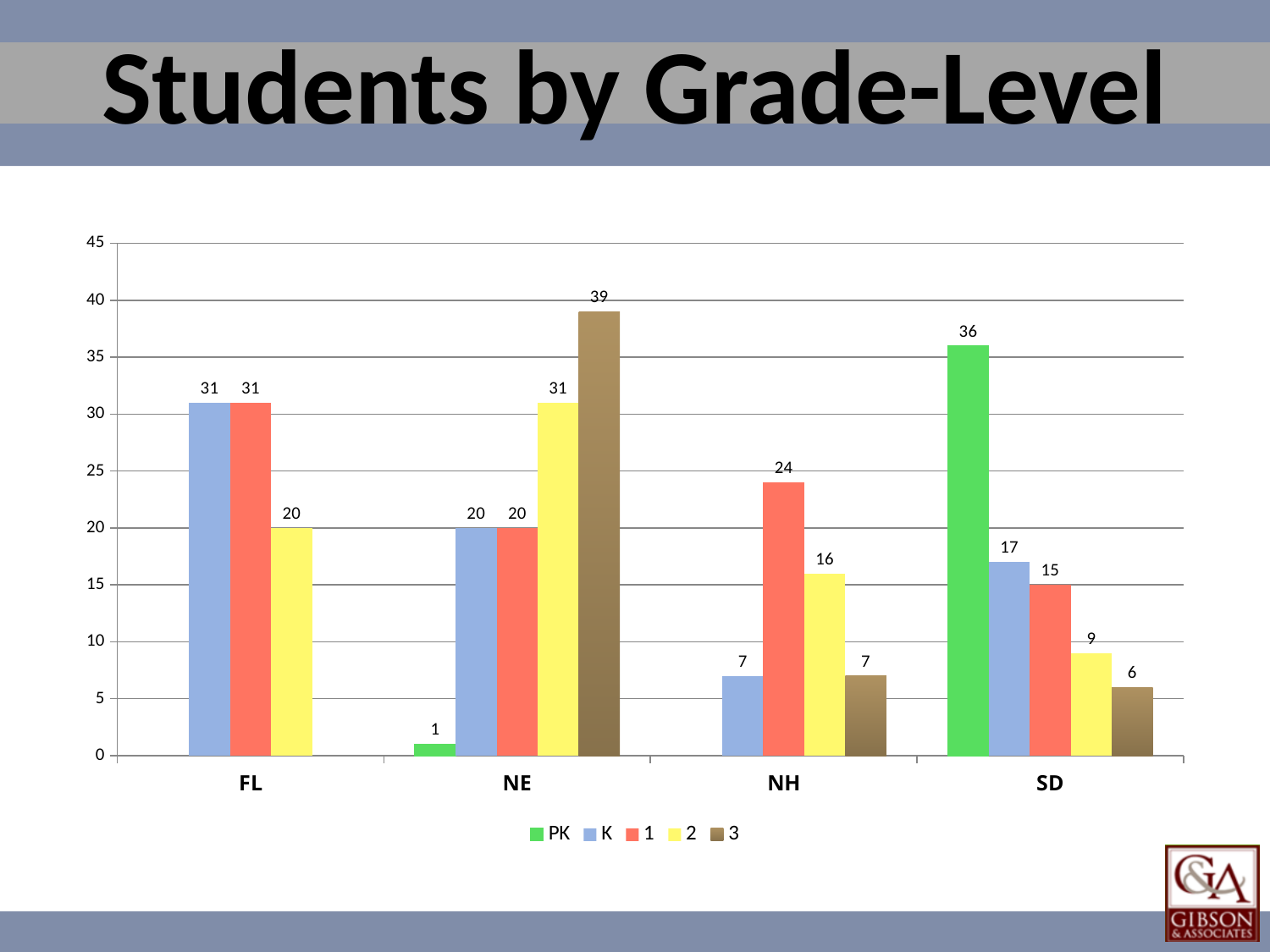
What is the value for grade 1 in NH? 24 What is the value for K in FL? 31 What is the difference between the grade 2 value and the grade 3 value in SD? 3 What kind of chart is shown on the slide? bar chart Is the value for PK in NE greater or less than 5? less Which grade level has the highest value in NE? 3 How many categories are shown on the x axis? 4 Which is larger in NH: the value for grade 1 or the value for grade 2? grade 1 How many series does the legend list? 5 What is the value for grade 3 in NE? 39 Which grade level has the lowest value in SD? 3 What is the value for PK in SD? 36